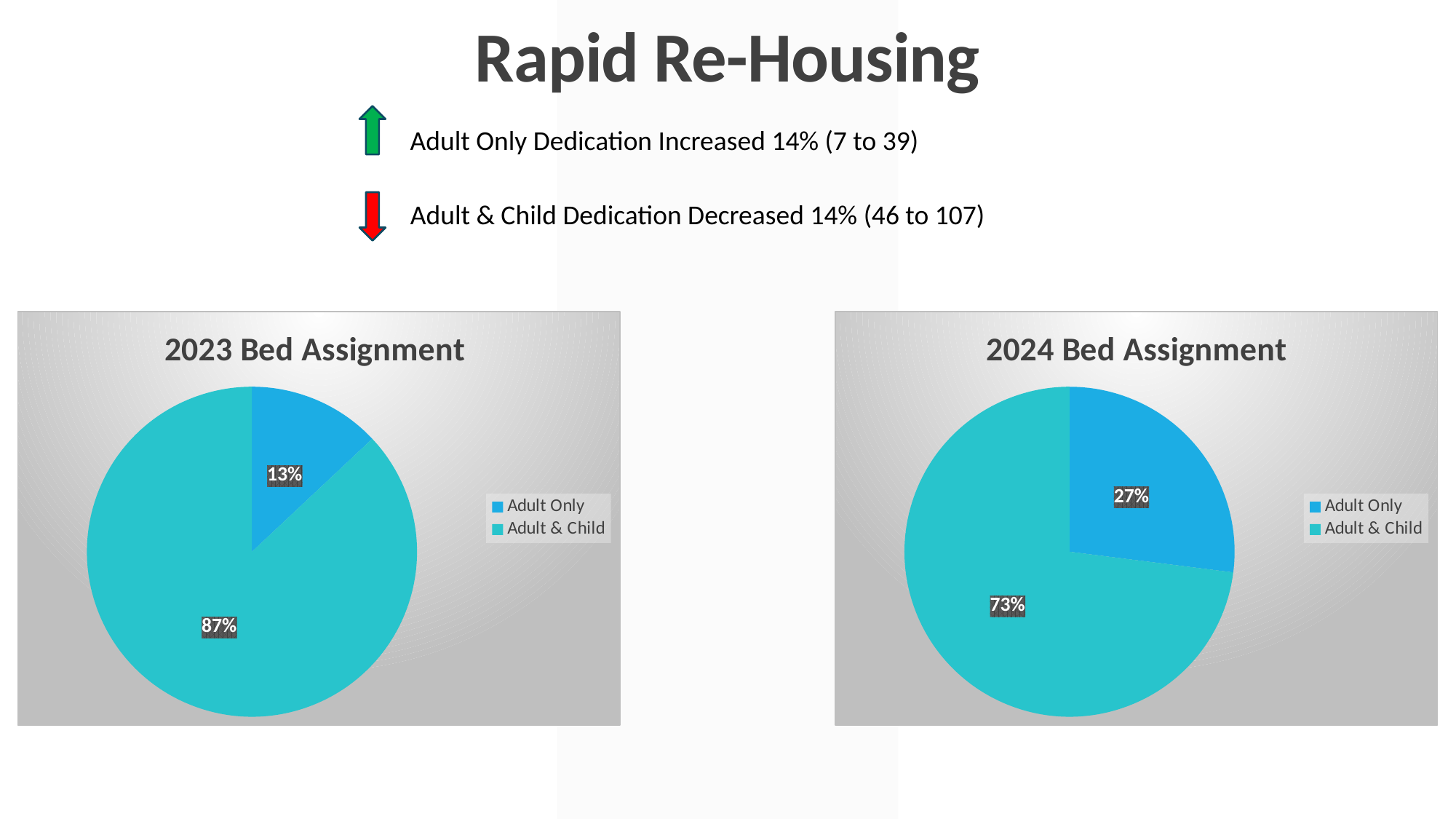
What is the title of the chart on the right side of the slide? 2024 Bed Assignment Is the Adult Only share larger in the 2023 Bed Assignment chart or the 2024 Bed Assignment chart? 2024 Bed Assignment How many categories does the 2024 Bed Assignment chart show? 2 In the 2024 Bed Assignment chart, what share of the pie is Adult Only? 27% In the 2023 Bed Assignment chart, which category has the largest slice? Adult & Child How many entries does the legend of the 2023 Bed Assignment chart list? 2 In the 2023 Bed Assignment chart, what share of the pie is Adult & Child? 87% In the 2024 Bed Assignment chart, which category has the smallest slice? Adult Only In the 2024 Bed Assignment chart, what share of the pie is Adult & Child? 73% In the 2023 Bed Assignment chart, what share of the pie is Adult Only? 13% In the 2024 Bed Assignment chart, what is the difference between the Adult & Child share and the Adult Only share? 46% What kind of chart is the 2023 Bed Assignment chart? Pie chart